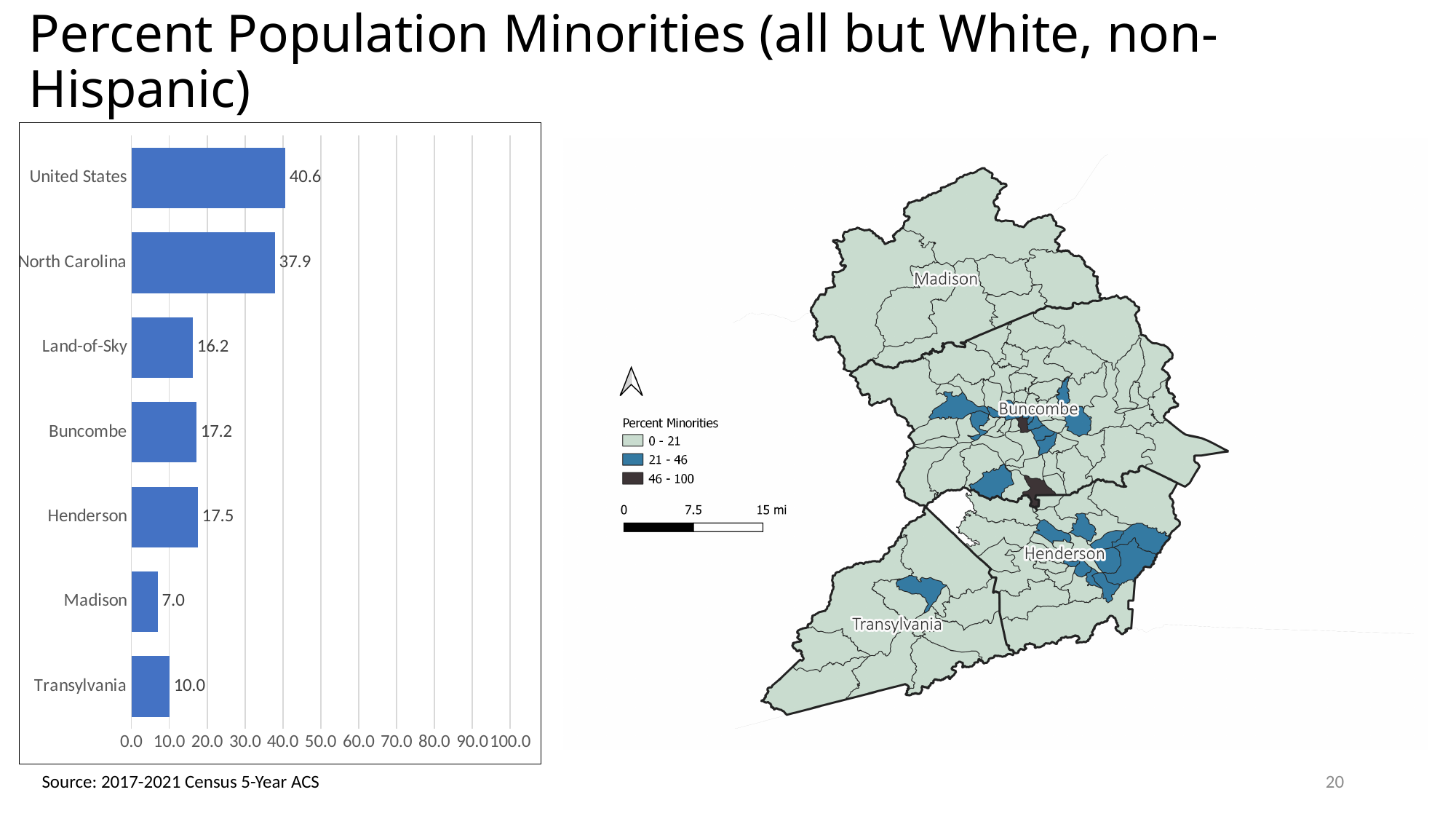
What is the highest value on the x axis of the bar chart? 100.0 Which category has the highest value in the bar chart? United States Is the value for North Carolina in the bar chart greater or less than 30.0? greater What is the value for Land-of-Sky in the bar chart? 16.2 What is the value for Madison in the bar chart? 7.0 Which category has the lowest value in the bar chart? Madison Which has a larger value in the bar chart, Transylvania or Buncombe? Buncombe What is the difference between the values for the United States and North Carolina in the bar chart? 2.7 How many categories are shown in the bar chart? 7 What kind of chart is shown on the left of the slide? bar chart What is the difference between the values for Henderson and Madison in the bar chart? 10.5 What is the value for the United States in the bar chart? 40.6